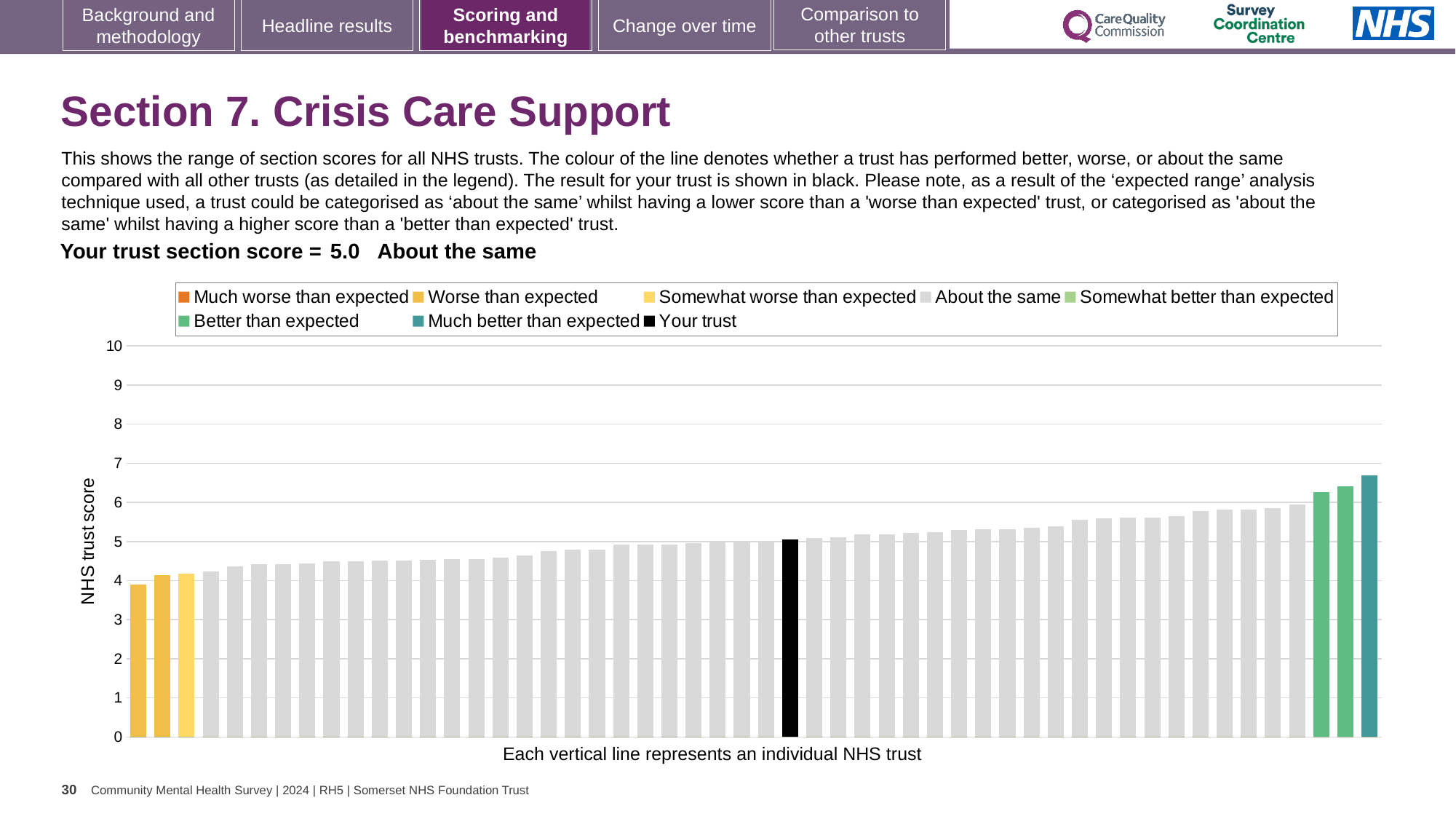
What is the trust section score printed on the slide? 5.0 Is the value of the shortest bar greater or less than 5? less What kind of chart is shown on the slide? bar chart Which legend category does the tallest bar belong to? Much better than expected What is the label on the y axis of the chart? NHS trust score Is the value of the black 'Your trust' bar greater or less than 4? greater How many entries does the chart legend list? 8 Do the bar values rise or fall from left to right along the x axis? rise Which legend category does the shortest bar belong to? Worse than expected Is the value of the tallest bar greater or less than 6? greater What is the highest value shown on the y axis? 10 Which is larger: the black 'Your trust' bar or the rightmost bar? the rightmost bar